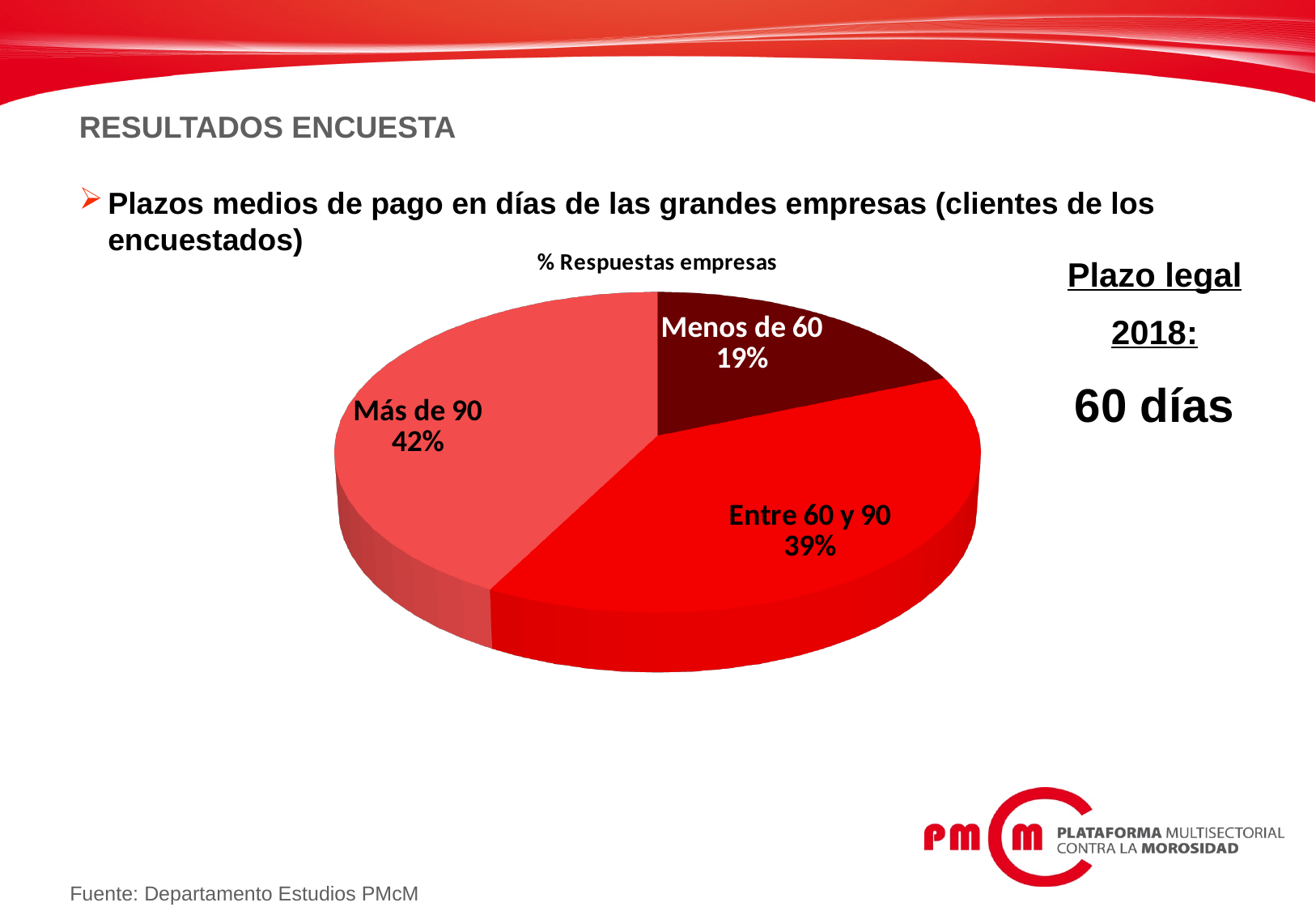
Which category has the smallest share of the pie? Menos de 60 What percentage of responses corresponds to 'Menos de 60'? 19% Which category has the largest share of the pie? Más de 90 What type of chart is shown on the slide? Pie chart What is the combined share of 'Más de 90' and 'Entre 60 y 90'? 81% Which is larger, the share for 'Entre 60 y 90' or the share for 'Menos de 60'? Entre 60 y 90 What is the title of the chart? % Respuestas empresas How many categories are shown in the pie chart? 3 What is the difference in percentage points between 'Entre 60 y 90' and 'Menos de 60'? 20 What is the difference in percentage points between 'Más de 90' and 'Menos de 60'? 23 What percentage of responses corresponds to 'Entre 60 y 90'? 39% What percentage of responses corresponds to 'Más de 90'? 42%